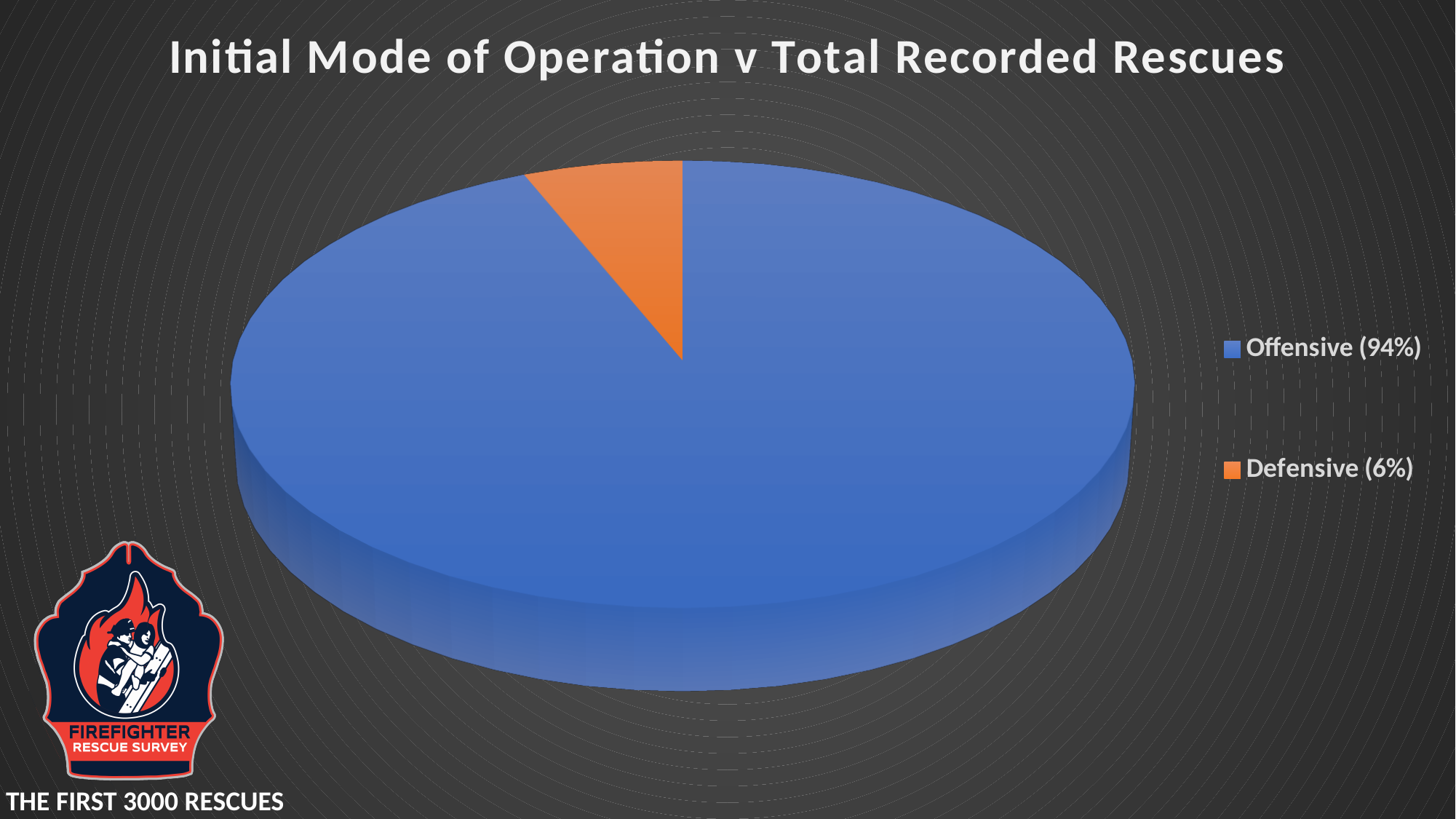
Which is larger, the Offensive share or the Defensive share? Offensive How many categories are shown in the pie chart? 2 What kind of chart is shown on the slide? pie chart Which category has the smallest slice of the pie? Defensive What is the difference in percentage points between the Offensive and Defensive shares? 88 What is the title of the chart? Initial Mode of Operation v Total Recorded Rescues What share of the pie does Offensive represent? 94% What colour is the Defensive slice? orange Which category has the largest slice of the pie? Offensive What share of the pie does Defensive represent? 6%